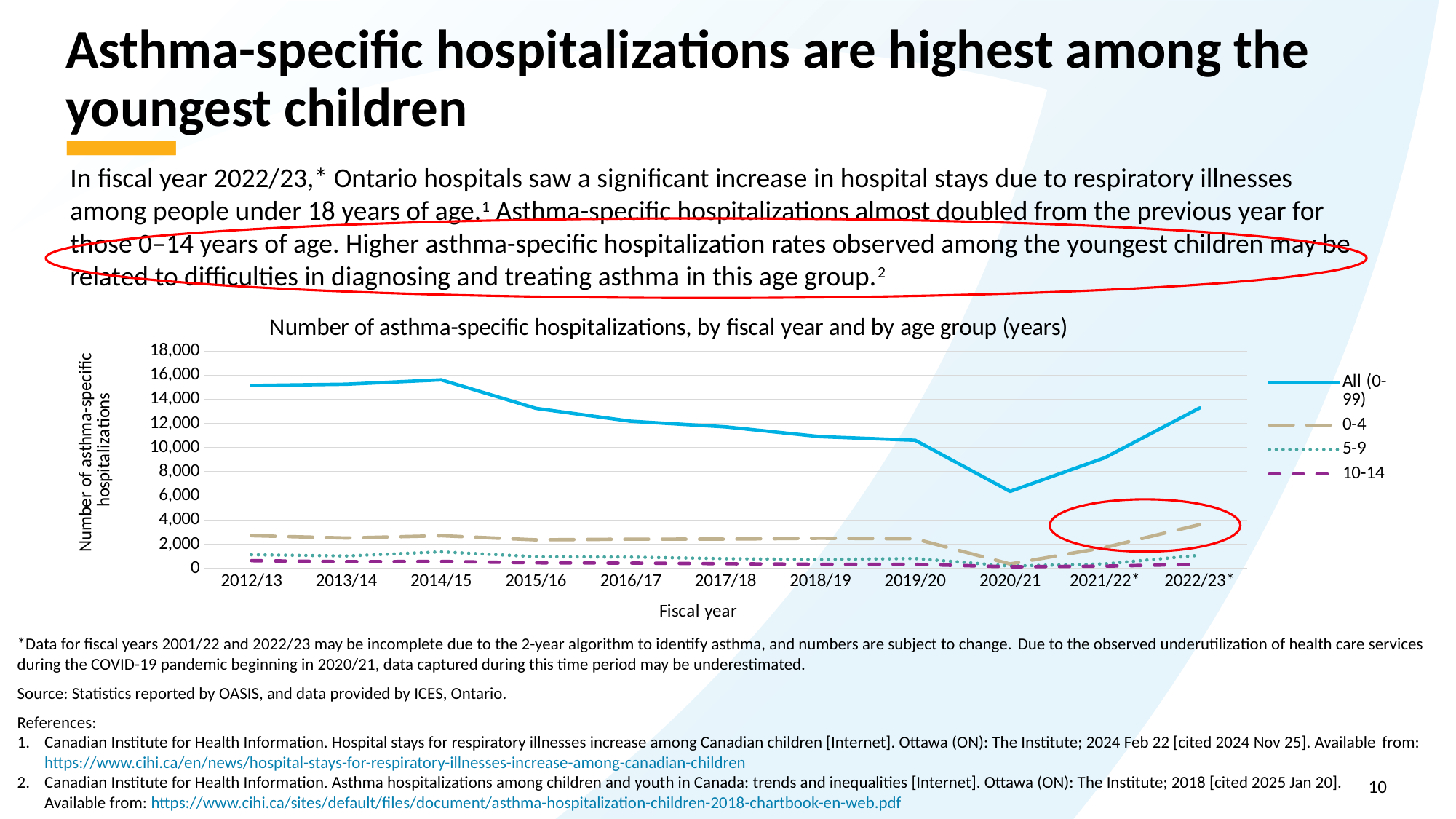
Is the value for All (0-99) in 2020/21 greater or less than 8,000? less How many series does the legend list? 4 How many fiscal years are plotted along the x axis? 11 What kind of chart is shown on the slide? Line chart In which fiscal year is the All (0-99) series at its lowest? 2020/21 What is the title of the chart? Number of asthma-specific hospitalizations, by fiscal year and by age group (years) Does the All (0-99) series rise or fall from 2014/15 to 2020/21? Fall In which fiscal year is the 0-4 series at its highest? 2022/23* Is the value for All (0-99) in 2012/13 greater or less than 14,000? greater What is the label of the x axis? Fiscal year Is the value for the 0-4 age group in 2022/23* greater or less than 2,000? greater Which is larger for All (0-99): the value in 2019/20 or the value in 2020/21? 2019/20